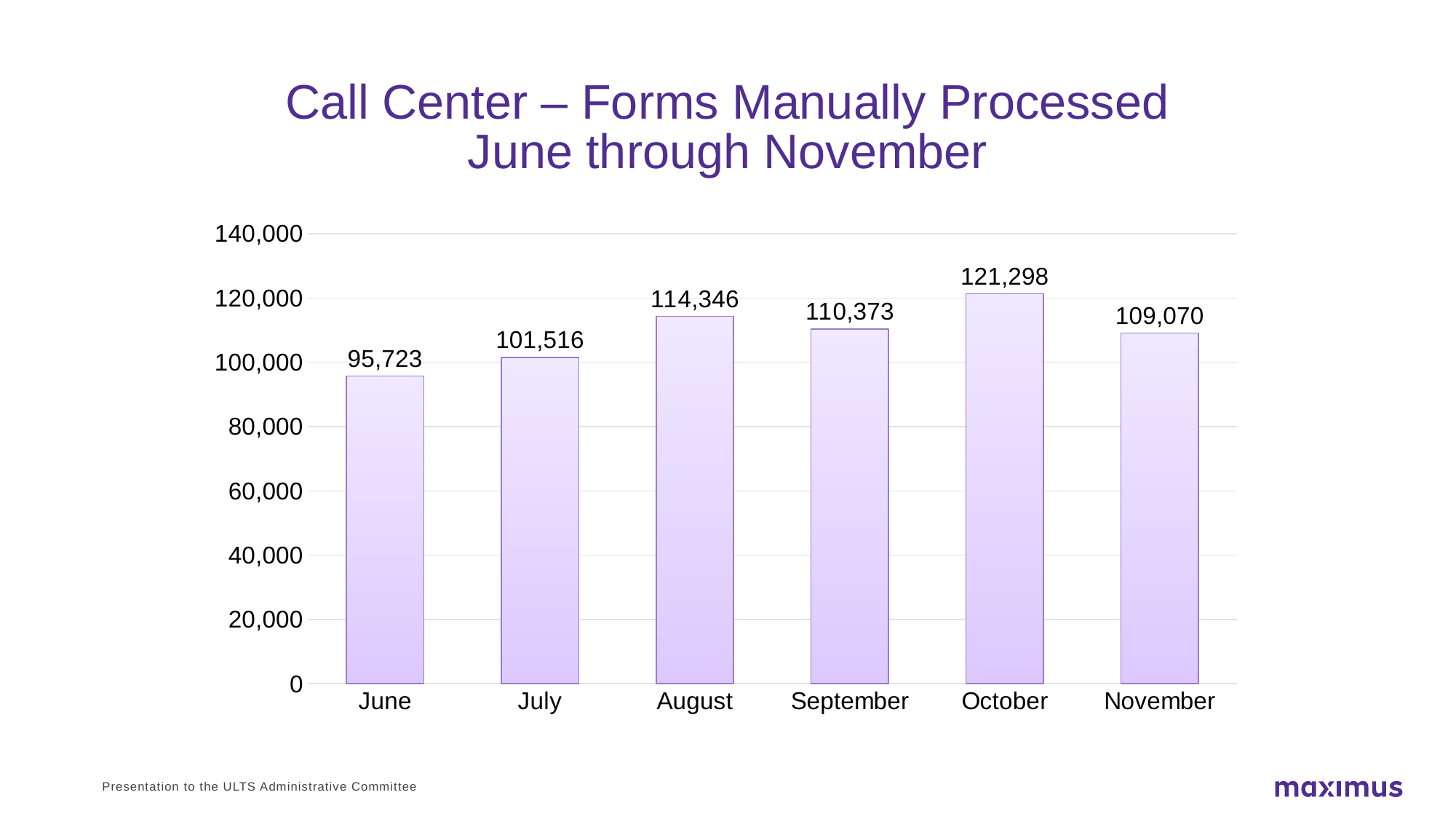
What is the difference between the September and November values? 1,303 Is the value for October greater or less than 120,000? greater How many forms were manually processed in August? 114,346 What is the value shown for June? 95,723 What is the title of the chart? Call Center – Forms Manually Processed June through November What kind of chart is shown on the slide? bar chart What is the difference between the October and June values? 25,575 Which month has the highest number of forms manually processed? October How many months are shown on the x axis? 6 Which month has the lowest number of forms manually processed? June Which is larger, the value for July or the value for September? September What is the value shown for November? 109,070